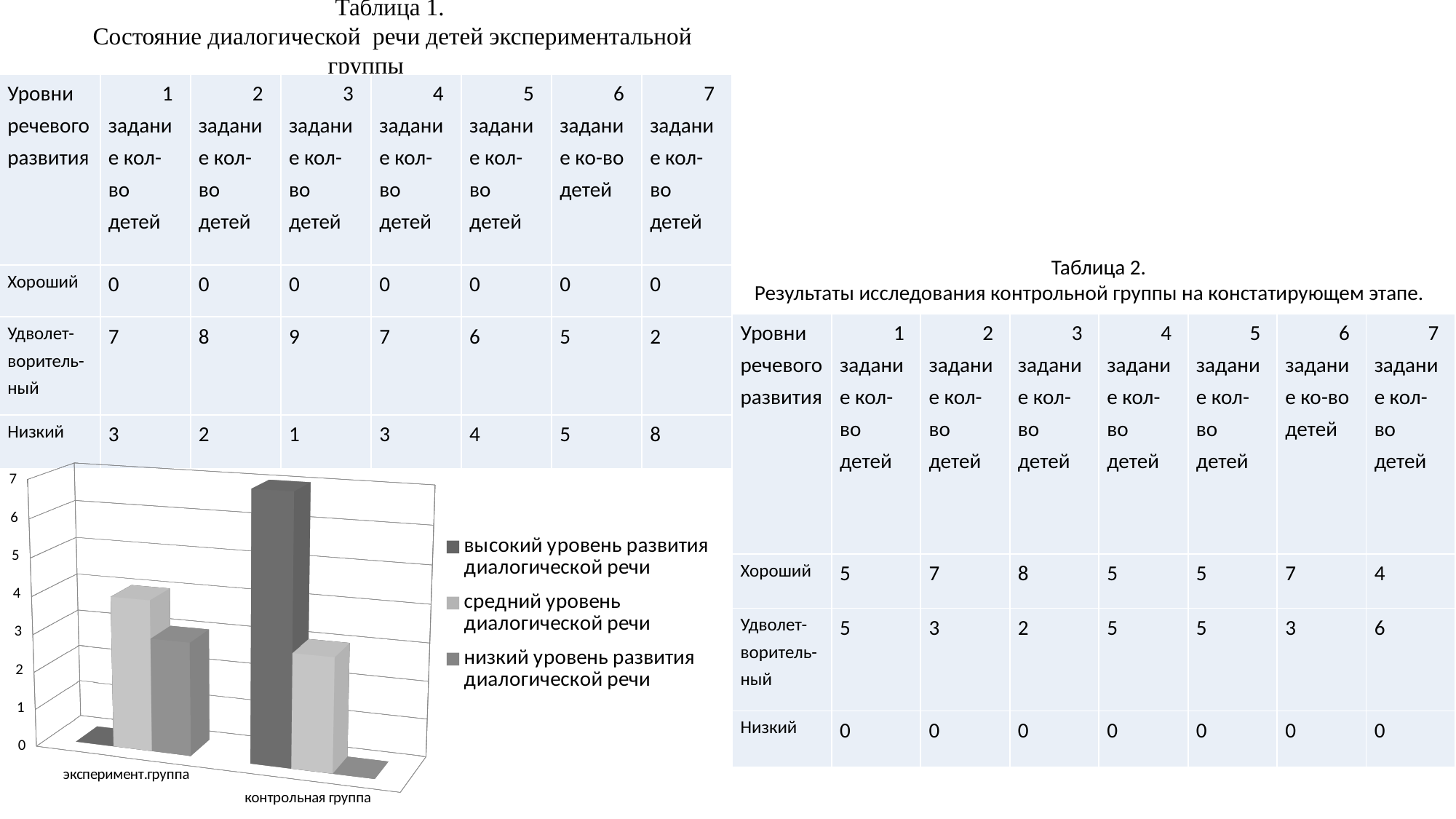
In the bar chart, which series has the highest bar for контрольная группа? высокий уровень развития диалогической речи What is the label of the first category on the x axis of the bar chart? эксперимент.группа In the bar chart, is the value for высокий уровень развития диалогической речи in эксперимент.группа greater or less than 1? less In the bar chart, which group has the larger value for высокий уровень развития диалогической речи: эксперимент.группа or контрольная группа? контрольная группа In the bar chart, is the value for низкий уровень развития диалогической речи in контрольная группа greater or less than 1? less In the bar chart, is the value for средний уровень развития диалогической речи in эксперимент.группа greater or less than 2? greater In the bar chart, which series has the highest bar for эксперимент.группа? средний уровень диалогической речи How many series does the legend of the bar chart list? 3 How many groups (categories) are shown on the x axis of the bar chart? 2 In the bar chart, which series has the lowest bar for эксперимент.группа? высокий уровень развития диалогической речи What kind of chart is shown at the bottom left of the slide? bar chart